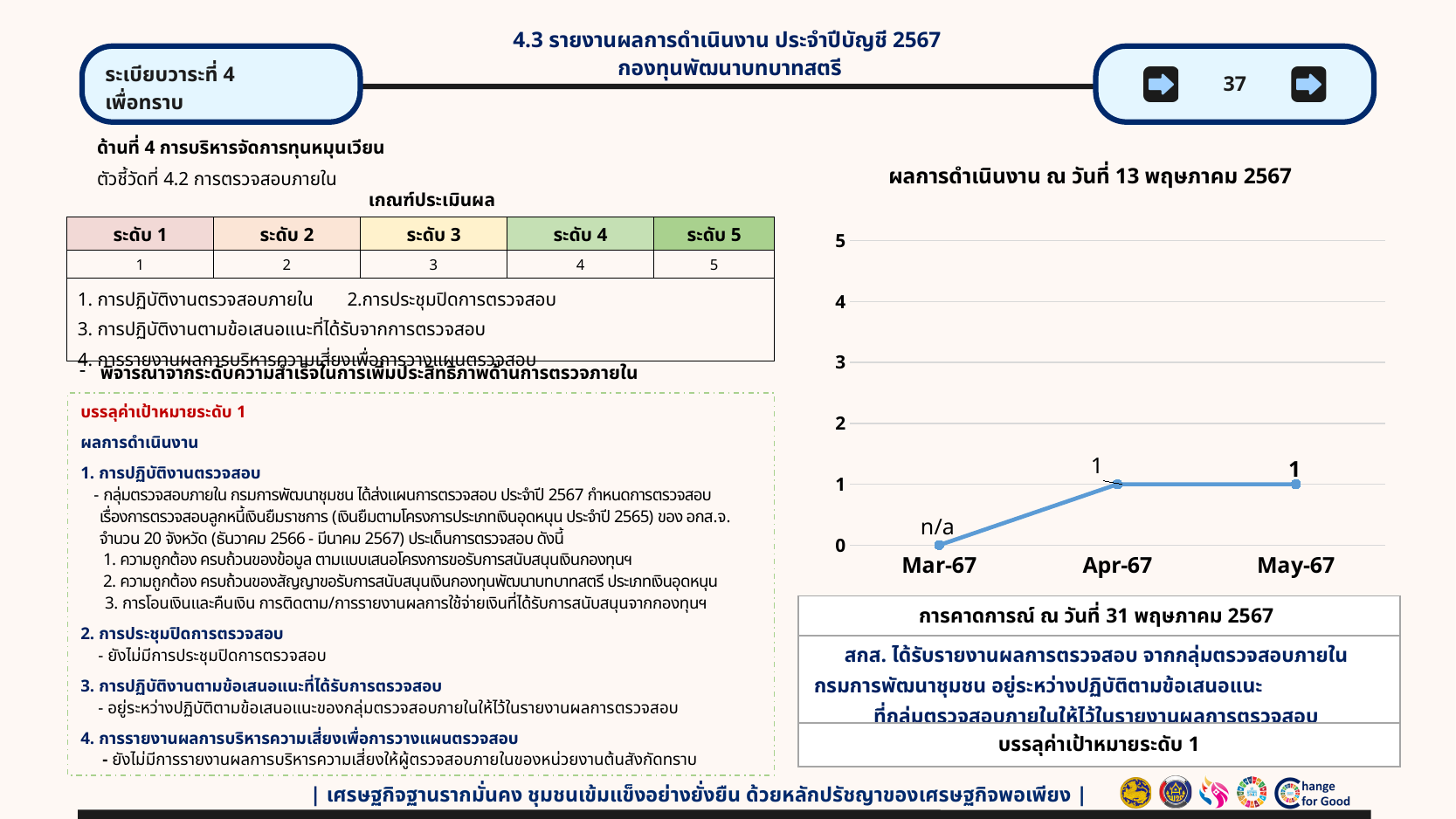
Which month is the first category on the x axis of the line chart? Mar-67 What is the title of the line chart? ผลการดำเนินงาน ณ วันที่ 13 พฤษภาคม 2567 How many points are plotted along the x axis of the line chart? 3 What is the highest value shown on the y axis of the line chart? 5 What kind of chart is shown on the slide? line chart What is the value for Apr-67 in the line chart? 1 What is the value for May-67 in the line chart? 1 Is the value for May-67 greater or less than 3? less What is the difference between the values for Apr-67 and May-67? 0 What data label is shown for Mar-67 in the line chart? n/a Does the line rise, fall or stay flat between Apr-67 and May-67? stays flat Is the value for Apr-67 greater or less than 2? less